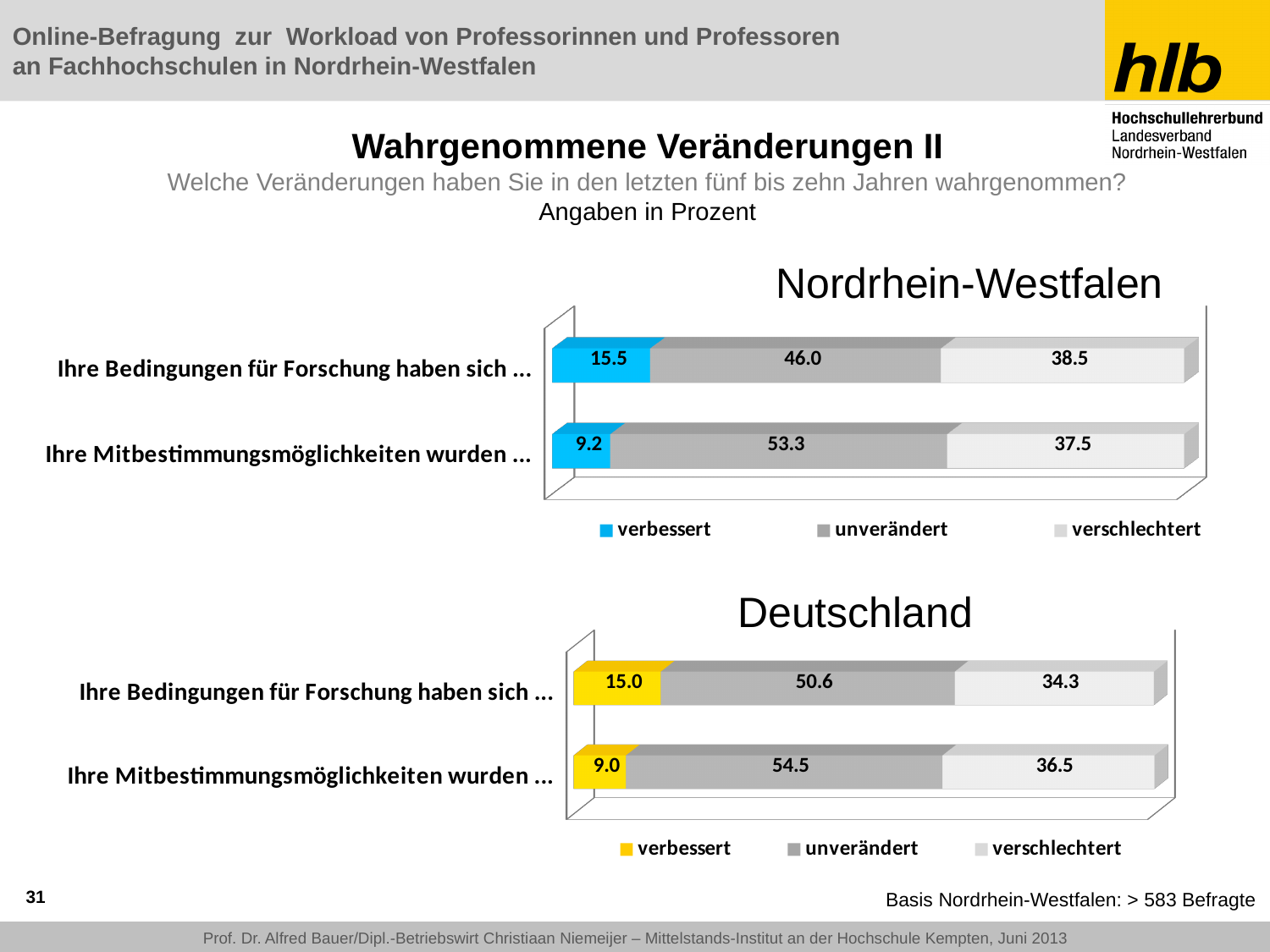
In the Deutschland chart, which colour represents "verbessert"? Yellow In the Nordrhein-Westfalen chart, what is the value for "unverändert" for "Ihre Mitbestimmungsmöglichkeiten wurden ..."? 53.3 In the Nordrhein-Westfalen chart, which category has the higher "verbessert" value? Ihre Bedingungen für Forschung haben sich ... How many categories are shown in the Nordrhein-Westfalen chart? 2 In the Nordrhein-Westfalen chart, what is the difference between the "verschlechtert" values for "Ihre Bedingungen für Forschung haben sich ..." and "Ihre Mitbestimmungsmöglichkeiten wurden ..."? 1.0 In the Deutschland chart, what is the difference between the "unverändert" values for "Ihre Mitbestimmungsmöglichkeiten wurden ..." and "Ihre Bedingungen für Forschung haben sich ..."? 3.9 What kind of chart is the Deutschland chart? Stacked bar chart In the Deutschland chart, what is the value for "verbessert" for "Ihre Mitbestimmungsmöglichkeiten wurden ..."? 9.0 How many series does the legend of the Deutschland chart list? 3 In the Nordrhein-Westfalen chart, what is the value for "verbessert" for "Ihre Bedingungen für Forschung haben sich ..."? 15.5 In the Nordrhein-Westfalen chart, what is the total of the stacked bar for "Ihre Mitbestimmungsmöglichkeiten wurden ..."? 100.0 In the Deutschland chart, what is the value for "verschlechtert" for "Ihre Bedingungen für Forschung haben sich ..."? 34.3